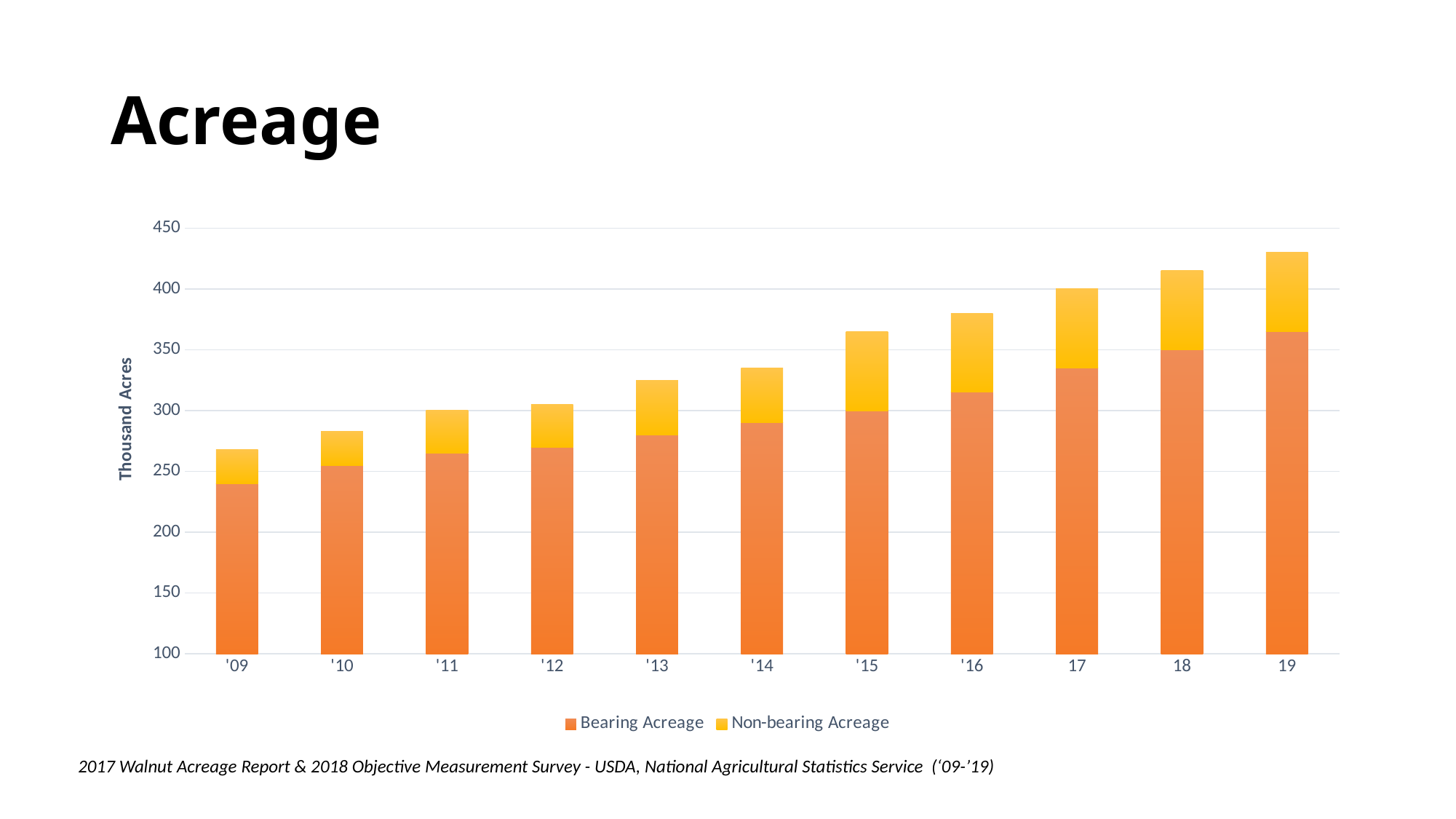
How many series does the legend list? 2 What kind of chart is shown on the slide? Stacked bar chart Which is larger, the total acreage for 18 or for '12? 18 Is the Bearing Acreage value for 17 greater or less than 350? less Is the total acreage for '15 greater or less than 350? greater Do the total acreage values rise or fall from '09 to 19? Rise How many years are shown on the x axis? 11 Which year has the lowest total acreage? '09 Which year has the highest total acreage? 19 Is the total acreage for 19 greater or less than 400? greater What is the label on the vertical axis? Thousand Acres